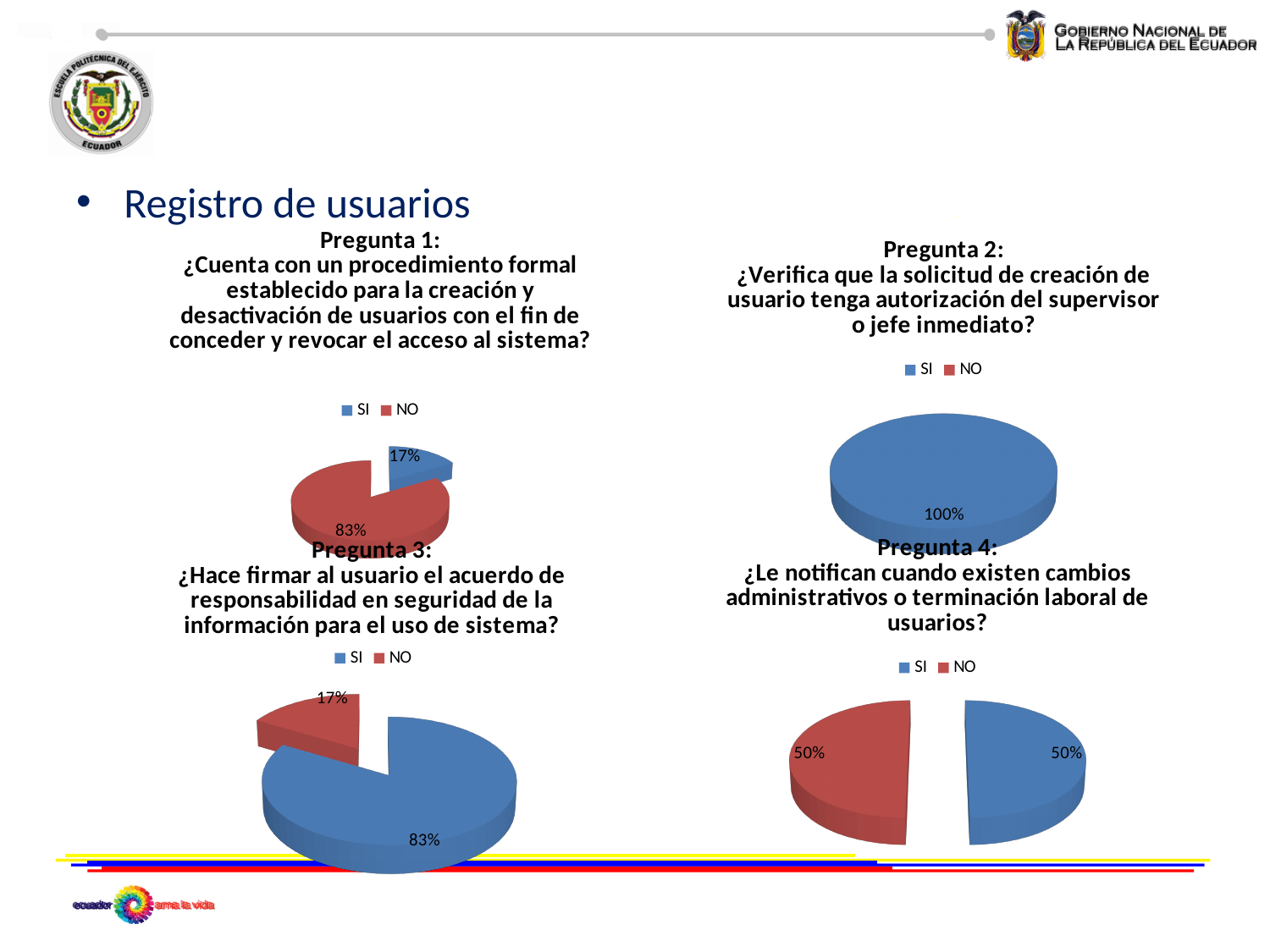
In the Pregunta 3 chart, which response has the largest share? SI In the Pregunta 3 chart, what percentage is shown for SI? 83% What kind of chart is used for Pregunta 4? Pie chart In the Pregunta 2 chart, what colour is the SI slice? Blue In the Pregunta 3 chart, what percentage is shown for NO? 17% In the Pregunta 4 chart, what percentage is shown for SI? 50% In the Pregunta 1 chart, what is the difference between the NO share and the SI share? 66% In the Pregunta 1 chart, which response has the larger share, SI or NO? NO In the Pregunta 1 chart, what percentage is shown for NO? 83% In the Pregunta 2 chart, what percentage is shown for SI? 100% In the Pregunta 1 chart, what percentage is shown for SI? 17% How many series does the legend of the Pregunta 3 chart list? 2